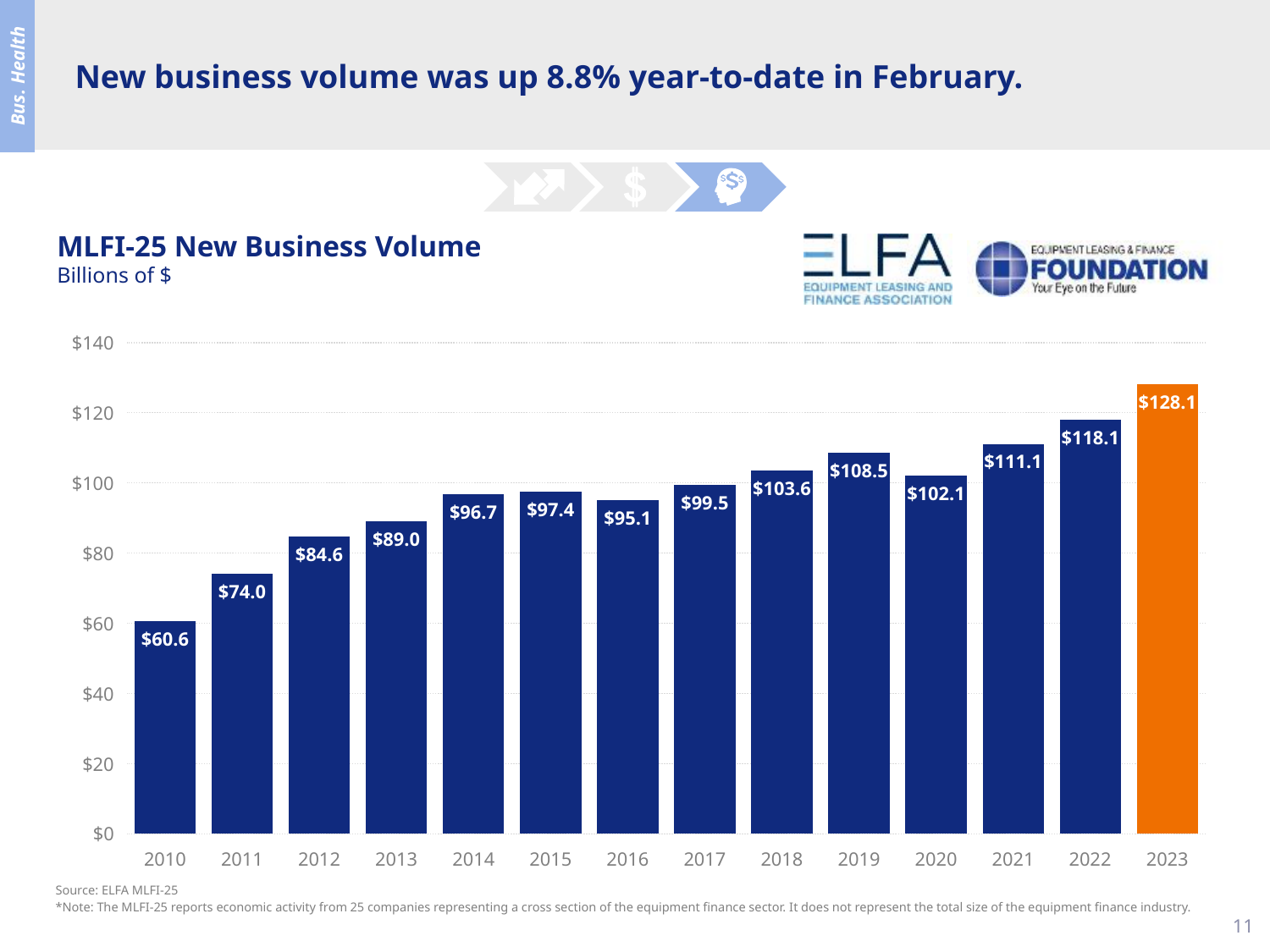
What is the MLFI-25 new business volume for 2010? $60.6 Is the value for 2021 greater or less than $100? greater Which year has the lowest new business volume? 2010 What kind of chart is shown on the slide? Bar chart Which bar is shown in a different colour (orange) from the others? 2023 What is the MLFI-25 new business volume for 2016? $95.1 Do the values generally rise or fall from 2010 to 2023? Rise What is the MLFI-25 new business volume for 2023? $128.1 Which year has the highest new business volume? 2023 How many years are shown on the chart? 14 What is the difference between the 2023 and 2022 new business volumes? $10.0 Which year had a larger new business volume, 2019 or 2020? 2019